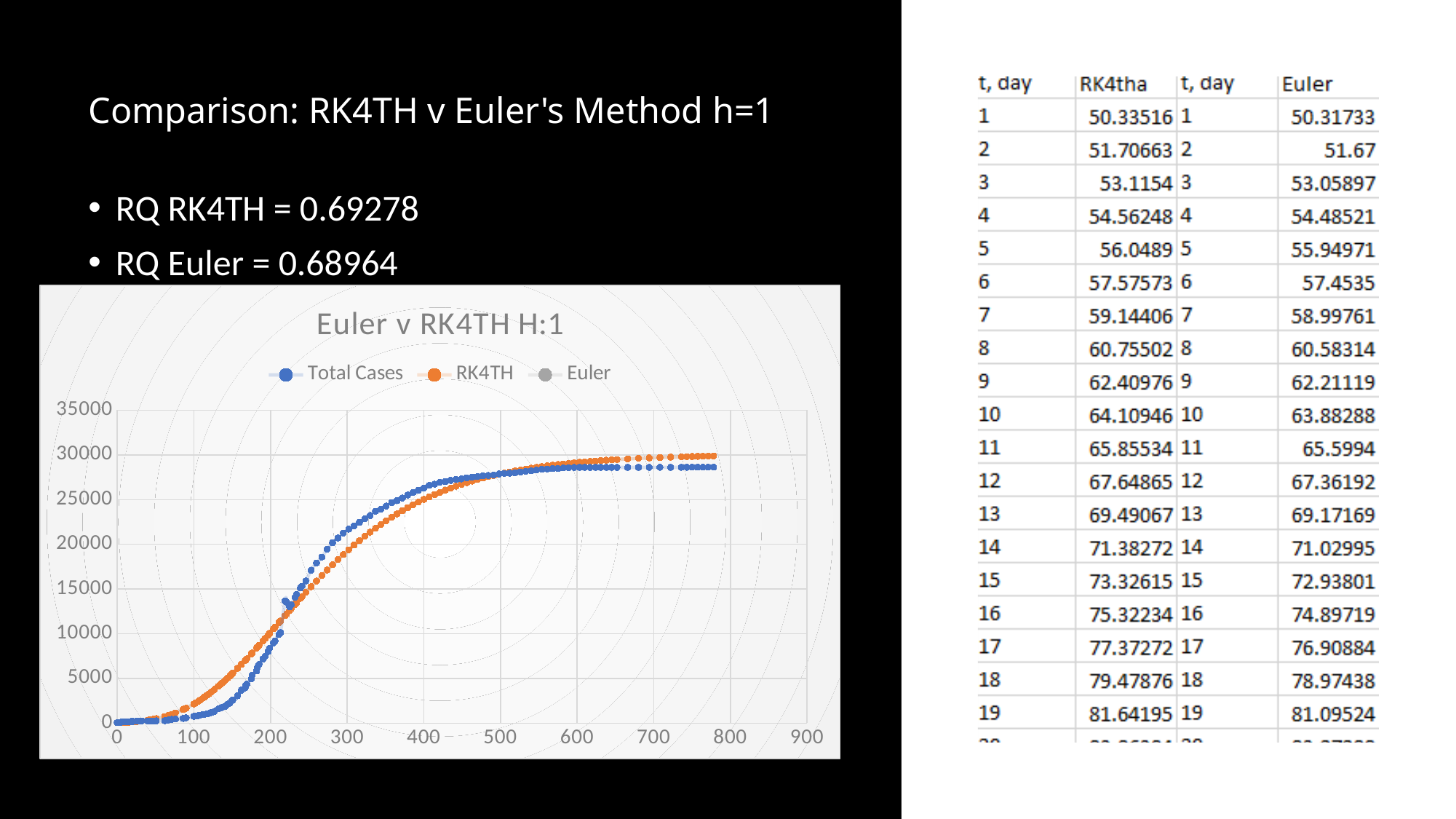
What kind of chart is shown on the slide? scatter chart At x = 300, which series has the larger value, Total Cases or RK4TH? Total Cases How many series does the chart legend list? 3 Is the RK4TH value at x = 400 greater or less than 20000? greater Do the Total Cases values rise or fall as the x axis increases from 0 to 800? rise Is the Total Cases value at x = 700 greater or less than 25000? greater At x = 700, which series has the larger value, Total Cases or RK4TH? RK4TH What is the highest value shown on the chart's y axis? 35000 What are the series names listed in the chart legend? Total Cases, RK4TH, Euler What is the title of the chart? Euler v RK4TH H:1 Is the RK4TH value at x = 700 greater or less than 25000? greater